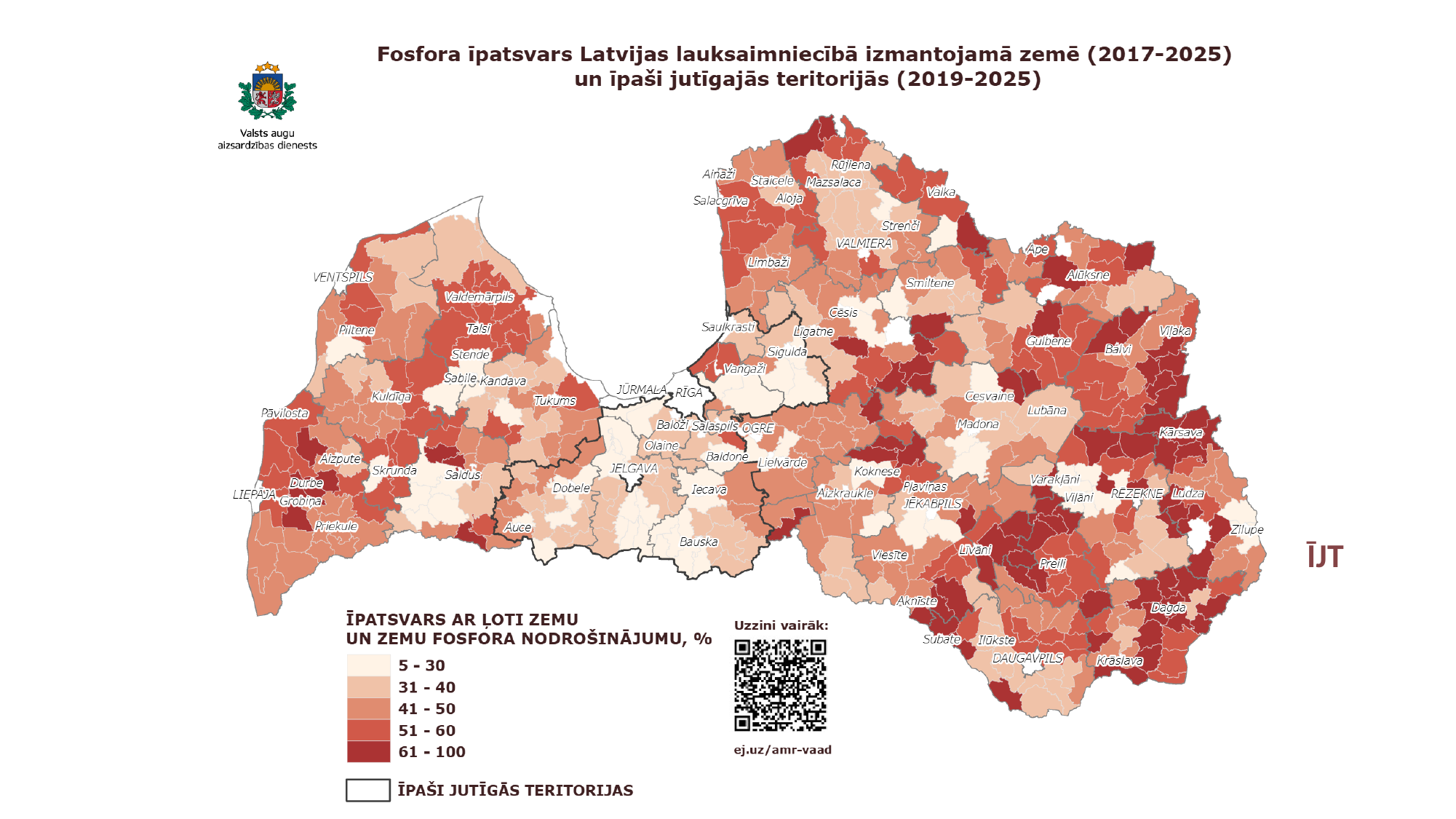
What value range does the lightest colour in the legend represent? 5 - 30 What is the highest value shown in the map legend? 100 How many colour classes does the map legend list for the share of land with very low and low phosphorus supply? 5 What kind of chart is shown on the slide? A choropleth map What web address is given under the QR code on the slide? ej.uz/amr-vaad What do the black-outlined areas on the map represent, according to the legend? Īpaši jutīgās teritorijas What value range does the middle (third) colour class in the legend represent? 41 - 50 What value range does the second-darkest colour class in the legend represent? 51 - 60 What is the lowest value shown in the map legend? 5 What value range does the darkest colour in the legend represent? 61 - 100 What value range does the second-lightest colour class in the legend represent? 31 - 40